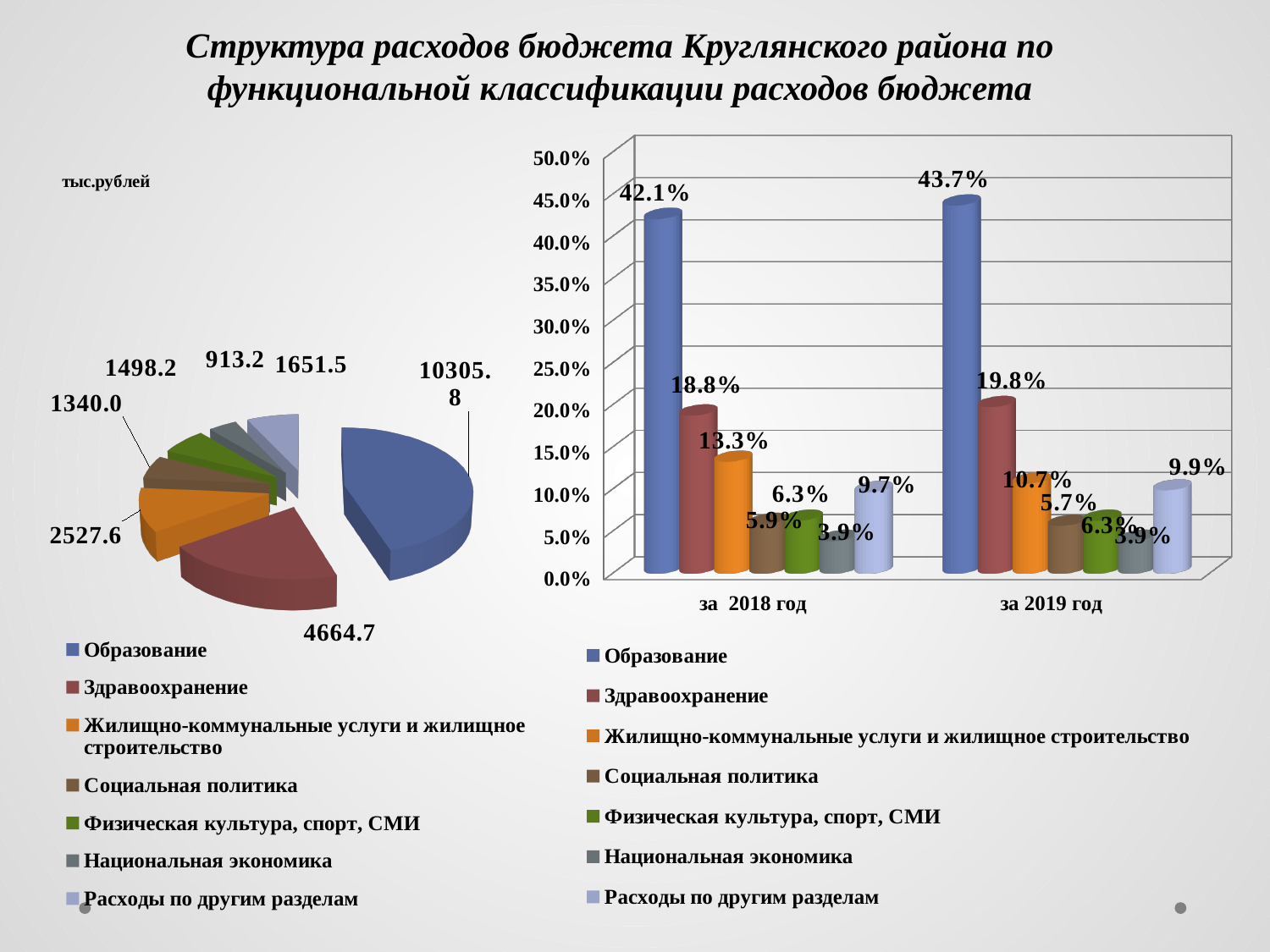
In the pie chart on the left, what unit is stated above the chart? тыс.рублей In the pie chart on the left, what is the value for Образование? 10305.8 In the pie chart on the left, which category has the smallest slice? Национальная экономика In the bar chart on the right, what is the value for Жилищно-коммунальные услуги и жилищное строительство за 2018 год? 13.3% In the pie chart on the left, how many categories does the legend list? 7 In the bar chart on the right, what is the difference between Образование за 2019 год and Образование за 2018 год? 1.6% In the pie chart on the left, what is the difference between the values for Здравоохранение and Жилищно-коммунальные услуги и жилищное строительство? 2137.1 What kind of chart is shown on the right side of the slide? bar chart In the bar chart on the right, how many series does the legend list? 7 In the bar chart on the right, what is the value for Образование за 2019 год? 43.7% In the bar chart on the right, which is larger: Здравоохранение за 2018 год or Здравоохранение за 2019 год? за 2019 год In the pie chart on the left, what is the value for Здравоохранение? 4664.7